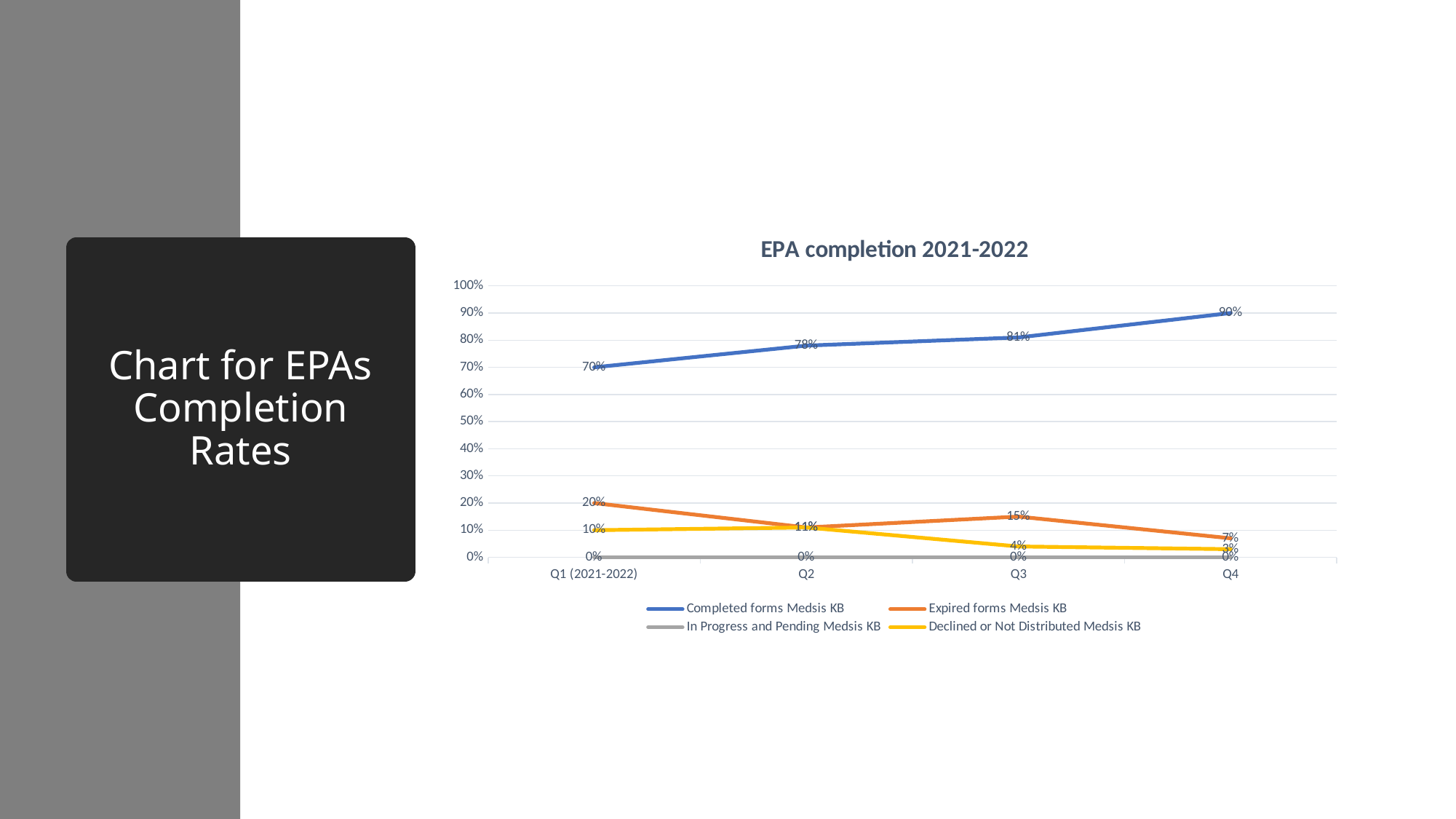
What is the value for Expired forms Medsis KB in Q1 (2021-2022)? 20% What is the value for Declined or Not Distributed Medsis KB in Q3? 4% Which is larger in Q3: Expired forms Medsis KB or Declined or Not Distributed Medsis KB? Expired forms Medsis KB How many series does the legend list? 4 How many quarters are plotted along the x axis? 4 What is the difference between Completed forms Medsis KB in Q4 and in Q1 (2021-2022)? 20% What is the value for Completed forms Medsis KB in Q4? 90% Does Completed forms Medsis KB rise or fall from Q1 (2021-2022) to Q4? rise In which quarter is Expired forms Medsis KB lowest? Q4 What type of chart is shown on the slide? line chart In which quarter is Completed forms Medsis KB highest? Q4 What is the title of the chart? EPA completion 2021-2022